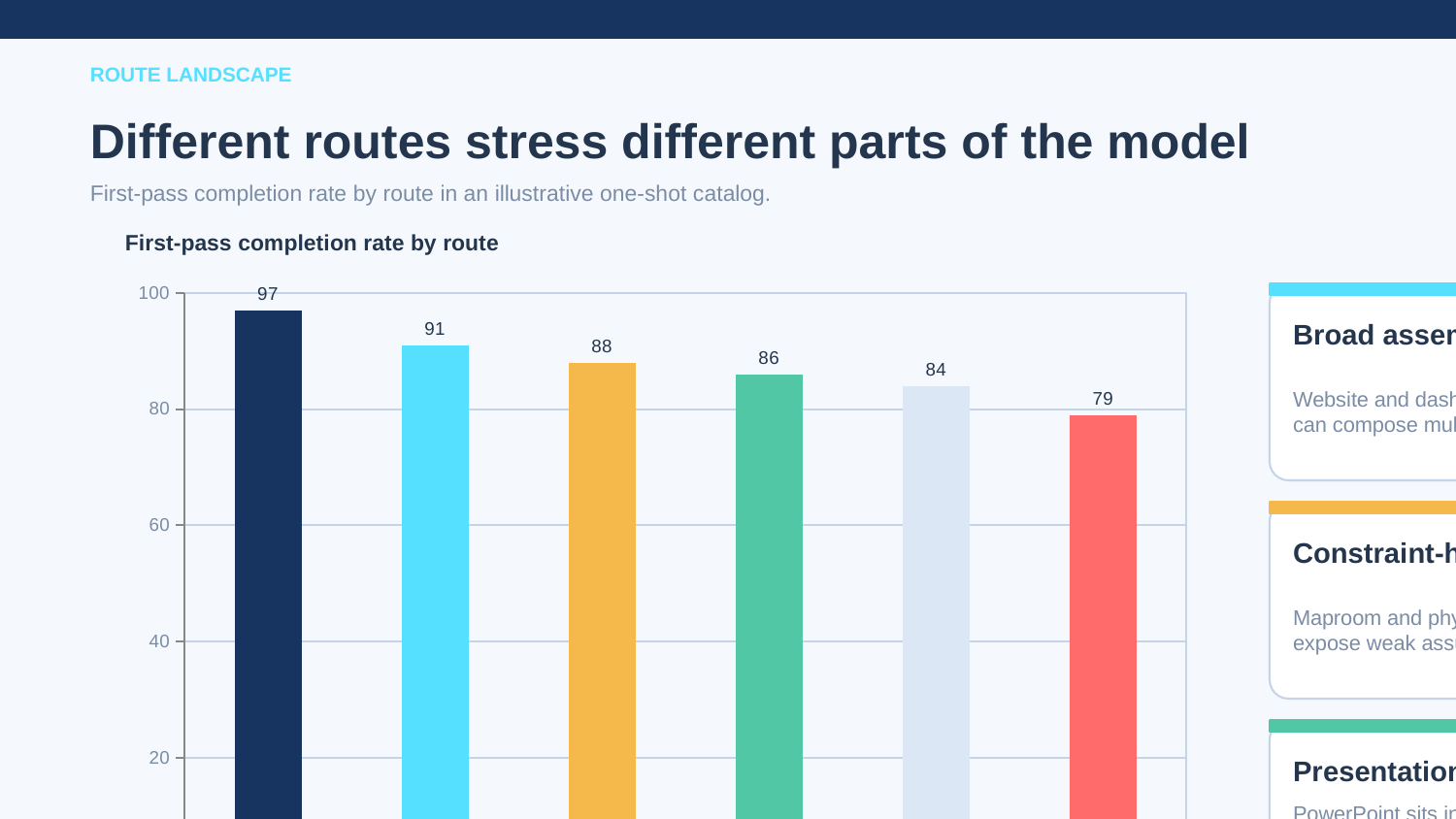
What is the lowest value shown in the chart? 79 Which is larger: the value of the light blue bar (second from left) or the green bar (fourth from left)? the light blue bar (91) What is the difference between the highest and lowest values in the chart? 18 What kind of chart is shown on the slide? bar chart How many bars are plotted in the chart? 6 What is the value of the red bar (rightmost)? 79 Do the values rise or fall moving from left to right across the bars? fall What is the highest value shown in the chart? 97 What is the value of the orange bar (third from the left)? 88 What is the title of the chart? First-pass completion rate by route What is the value of the first (leftmost, dark navy) bar? 97 Is the value of the rightmost (red) bar greater or less than 80? less